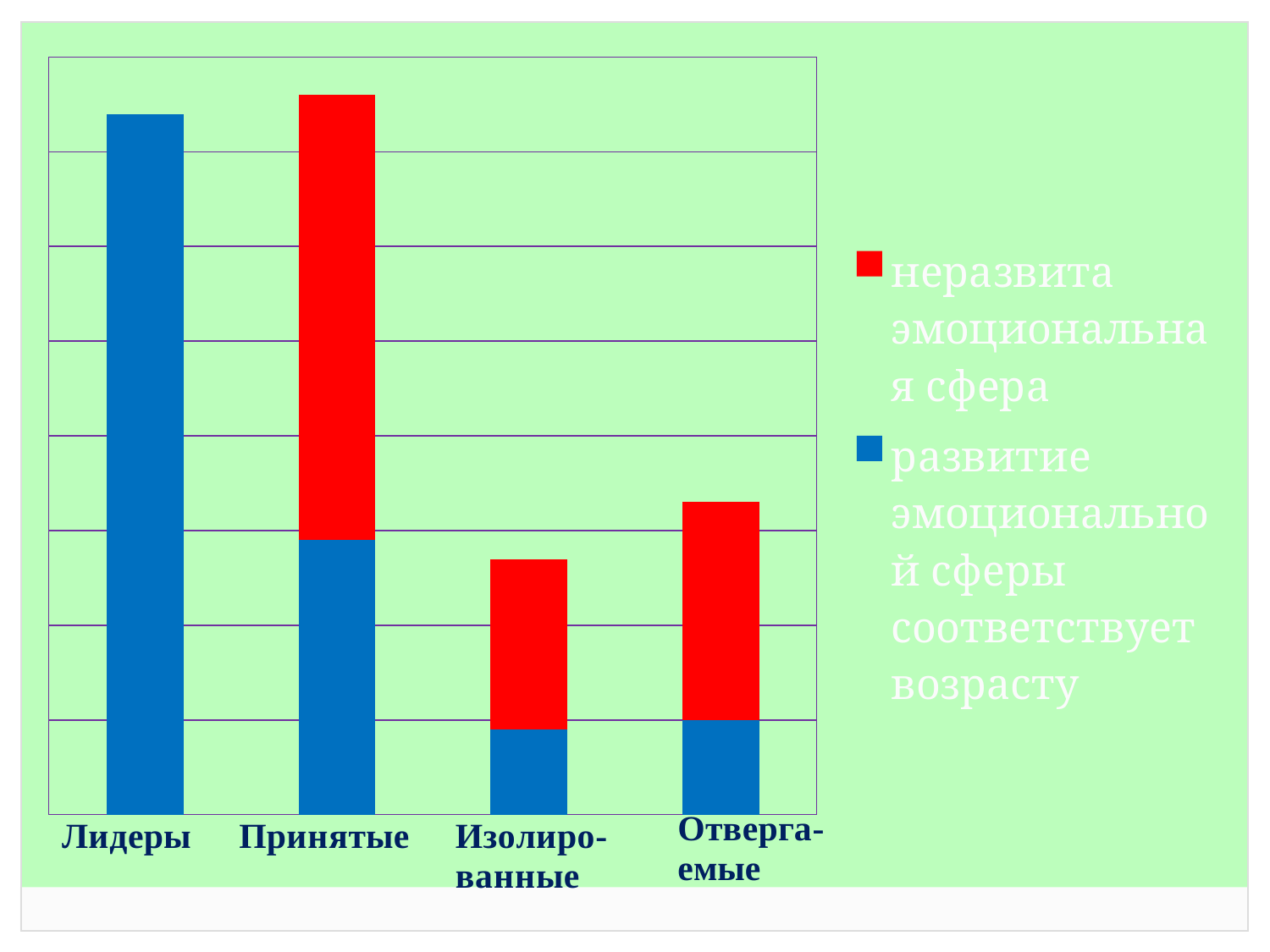
What kind of chart is shown on the slide? stacked bar chart Which category has the largest blue segment (развитие эмоциональной сферы соответствует возрасту)? Лидеры How many series does the chart's legend list? 2 Which colour represents the series 'неразвита эмоциональная сфера' in the legend? red Which category has no red segment (неразвита эмоциональная сфера) at all? Лидеры Which category has the largest red segment (неразвита эмоциональная сфера)? Принятые Which category has the tallest stacked bar overall? Принятые Is the blue segment larger for Лидеры or for Принятые? Лидеры How many categories are shown on the x axis of the chart? 4 Which category has the smallest red segment (неразвита эмоциональная сфера)? Изолированные Which category has the shortest stacked bar overall? Изолированные Is the red segment larger for Принятые or for Отвергаемые? Принятые